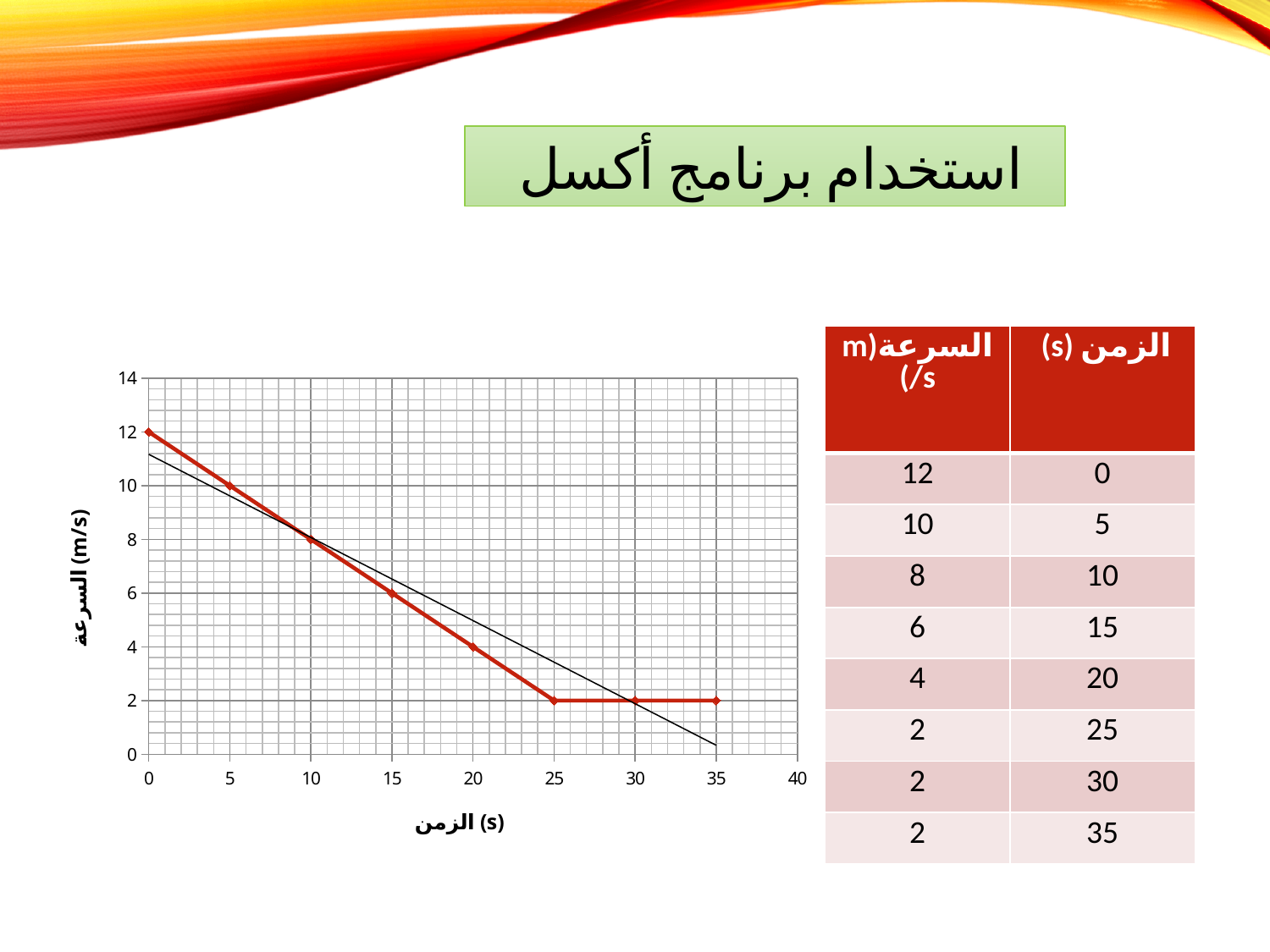
Does the speed rise or fall as time goes from 0 s to 25 s? fall How many data points are plotted on the red line? 8 Which has a larger speed: time 5 s or time 20 s? 5 s What is the difference between the speed at 0 s and the speed at 20 s? 8 At which time is the speed highest? 0 s What is the label on the x axis of the chart? الزمن (s) What is the speed at time 15 s? 6 What is the speed at time 30 s? 2 Is the speed at time 10 s greater or less than 10? less What is the lowest speed value plotted on the chart? 2 What is the speed (السرعة) at time 0 s? 12 What kind of chart is shown on the slide? line chart